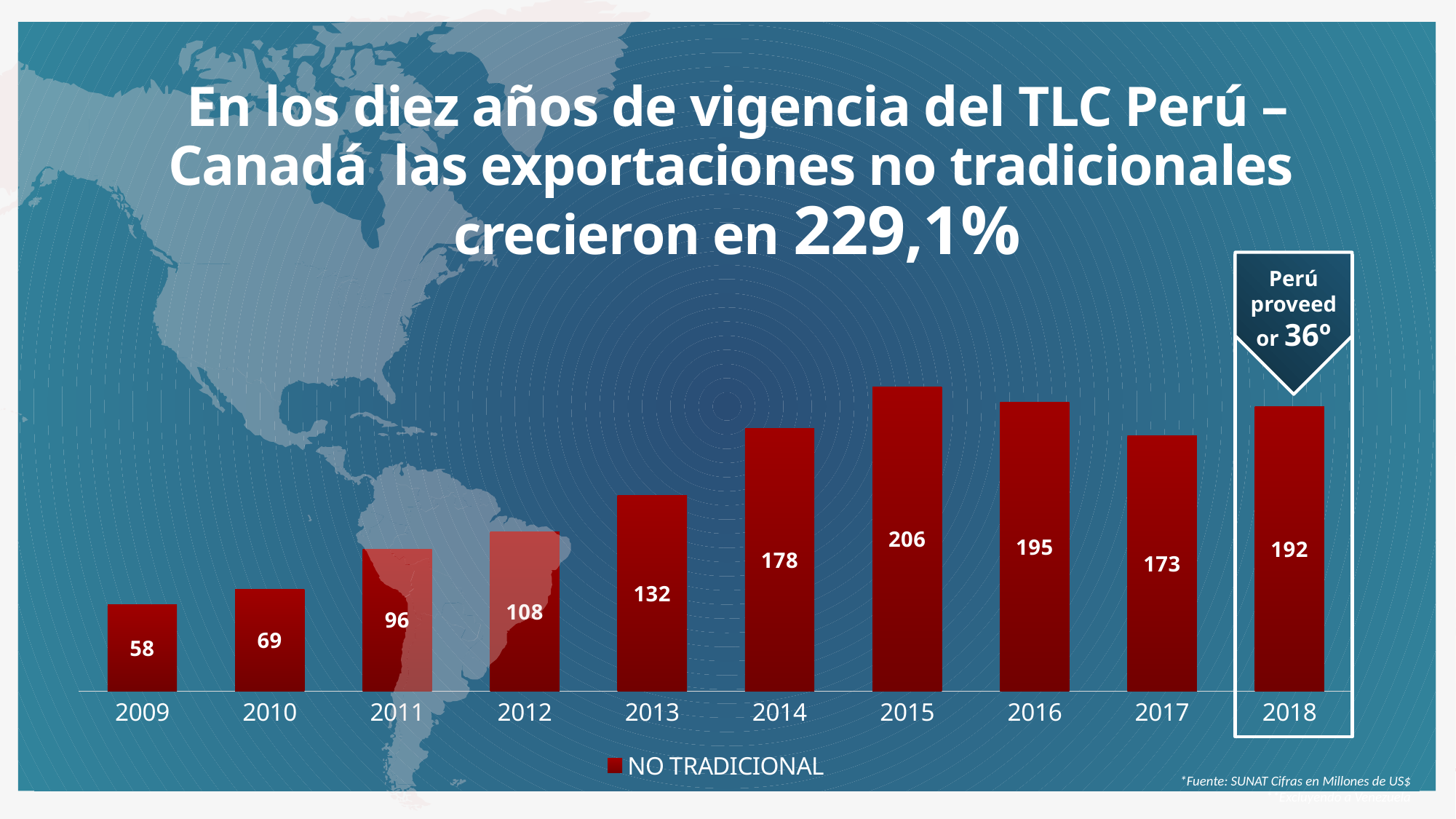
What is the difference between the values for 2015 and 2016? 11 What kind of chart is shown on the slide? bar chart How many series does the legend list? 1 What is the name of the series shown in the legend? NO TRADICIONAL Which year has the highest value? 2015 What is the value for 2015? 206 What is the value for 2009? 58 How many years are shown on the x axis? 10 Which is larger, the value for 2017 or the value for 2018? 2018 What is the difference between the values for 2018 and 2009? 134 What is the value for 2018? 192 Which year has the lowest value? 2009